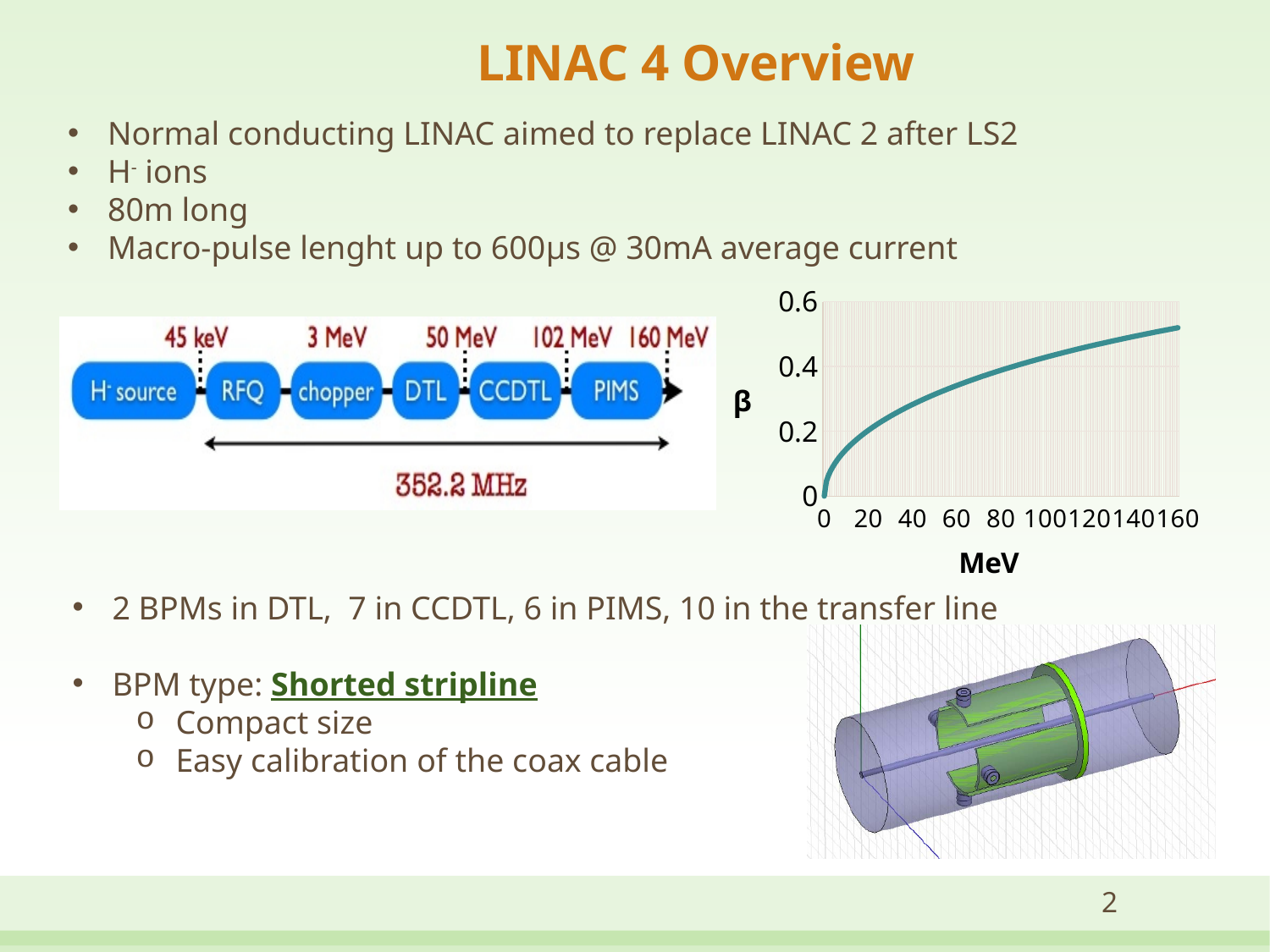
In the β versus MeV chart, is β larger at 160 MeV or at 20 MeV? 160 MeV What kind of chart is the β versus MeV chart on the slide? line chart In the β versus MeV chart, is the value of β at 40 MeV greater or less than 0.4? less In the β versus MeV chart, is the value of β at 160 MeV greater or less than 0.6? less What is the label of the vertical axis of the chart next to the LINAC layout? β What is the label of the horizontal axis of the β chart? MeV In the β versus MeV chart, is the value of β at 60 MeV greater or less than 0.6? less In the β versus MeV chart, does β rise or fall as the energy in MeV increases? rise